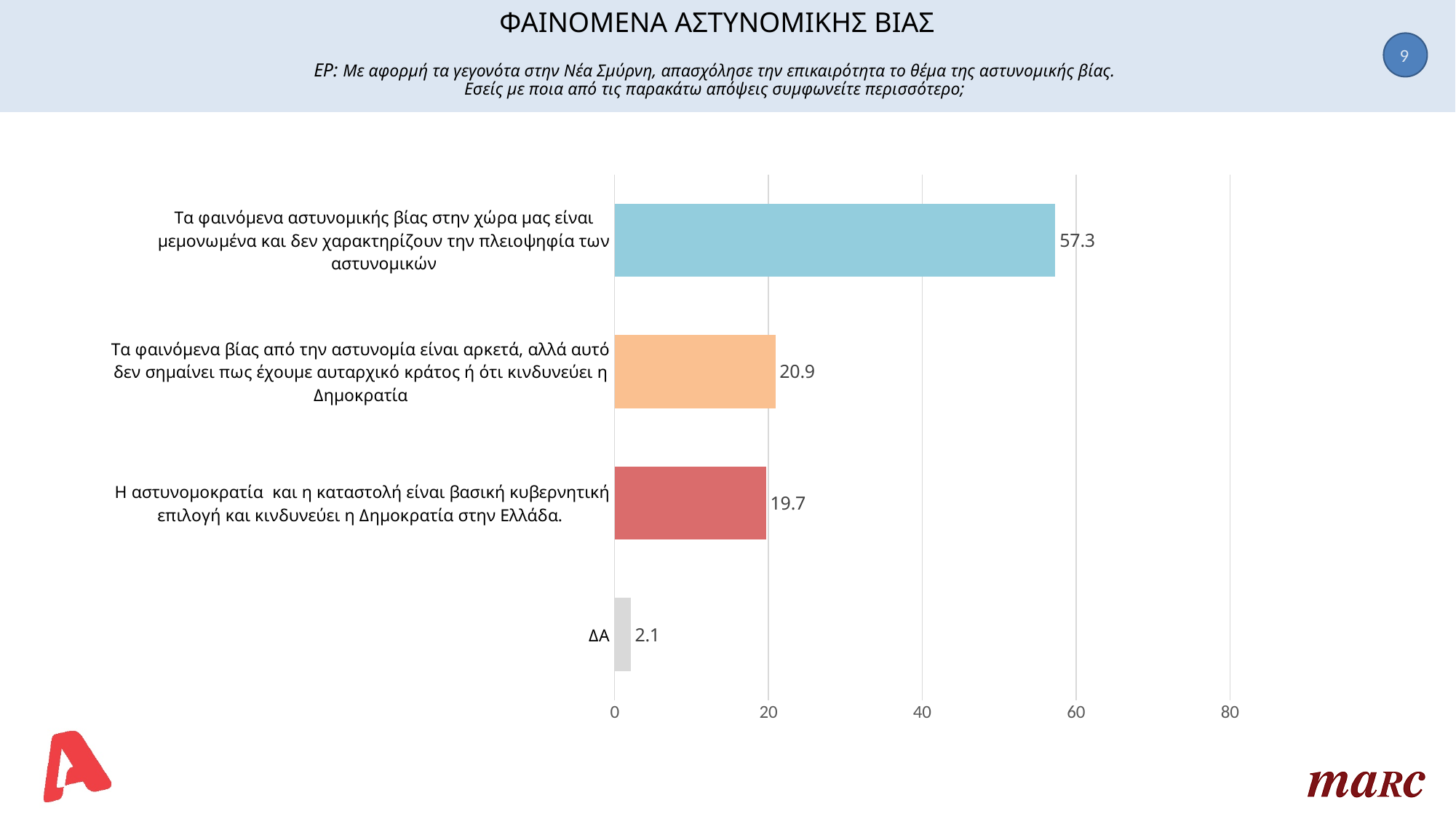
Which category has the highest value? Τα φαινόμενα αστυνομικής βίας στην χώρα μας είναι μεμονωμένα και δεν χαρακτηρίζουν την πλειοψηφία των αστυνομικών What value is shown for the category 'Η αστυνομοκρατία και η καταστολή είναι βασική κυβερνητική επιλογή και κινδυνεύει η Δημοκρατία στην Ελλάδα.'? 19.7 What kind of chart is shown on the slide? Bar chart What value is shown for the category 'Τα φαινόμενα αστυνομικής βίας στην χώρα μας είναι μεμονωμένα και δεν χαρακτηρίζουν την πλειοψηφία των αστυνομικών'? 57.3 How many categories are shown in the chart? 4 What is the highest value shown on the x axis? 80 What is the difference between the value for 'Τα φαινόμενα αστυνομικής βίας στην χώρα μας είναι μεμονωμένα...' (57.3) and the value for 'Τα φαινόμενα βίας από την αστυνομία είναι αρκετά...' (20.9)? 36.4 What value is shown for the category 'ΔΑ'? 2.1 What is the title of the slide? ΦΑΙΝΟΜΕΝΑ ΑΣΤΥΝΟΜΙΚΗΣ ΒΙΑΣ Which category has the lowest value? ΔΑ Is the value for 'Τα φαινόμενα αστυνομικής βίας στην χώρα μας είναι μεμονωμένα...' greater or less than 40? greater Which is larger: the value for 'Τα φαινόμενα βίας από την αστυνομία είναι αρκετά, αλλά αυτό δεν σημαίνει πως έχουμε αυταρχικό κράτος ή ότι κινδυνεύει η Δημοκρατία' or the value for 'Η αστυνομοκρατία και η καταστολή είναι βασική κυβερνητική επιλογή και κινδυνεύει η Δημοκρατία στην Ελλάδα.'? Τα φαινόμενα βίας από την αστυνομία είναι αρκετά, αλλά αυτό δεν σημαίνει πως έχουμε αυταρχικό κράτος ή ότι κινδυνεύει η Δημοκρατία